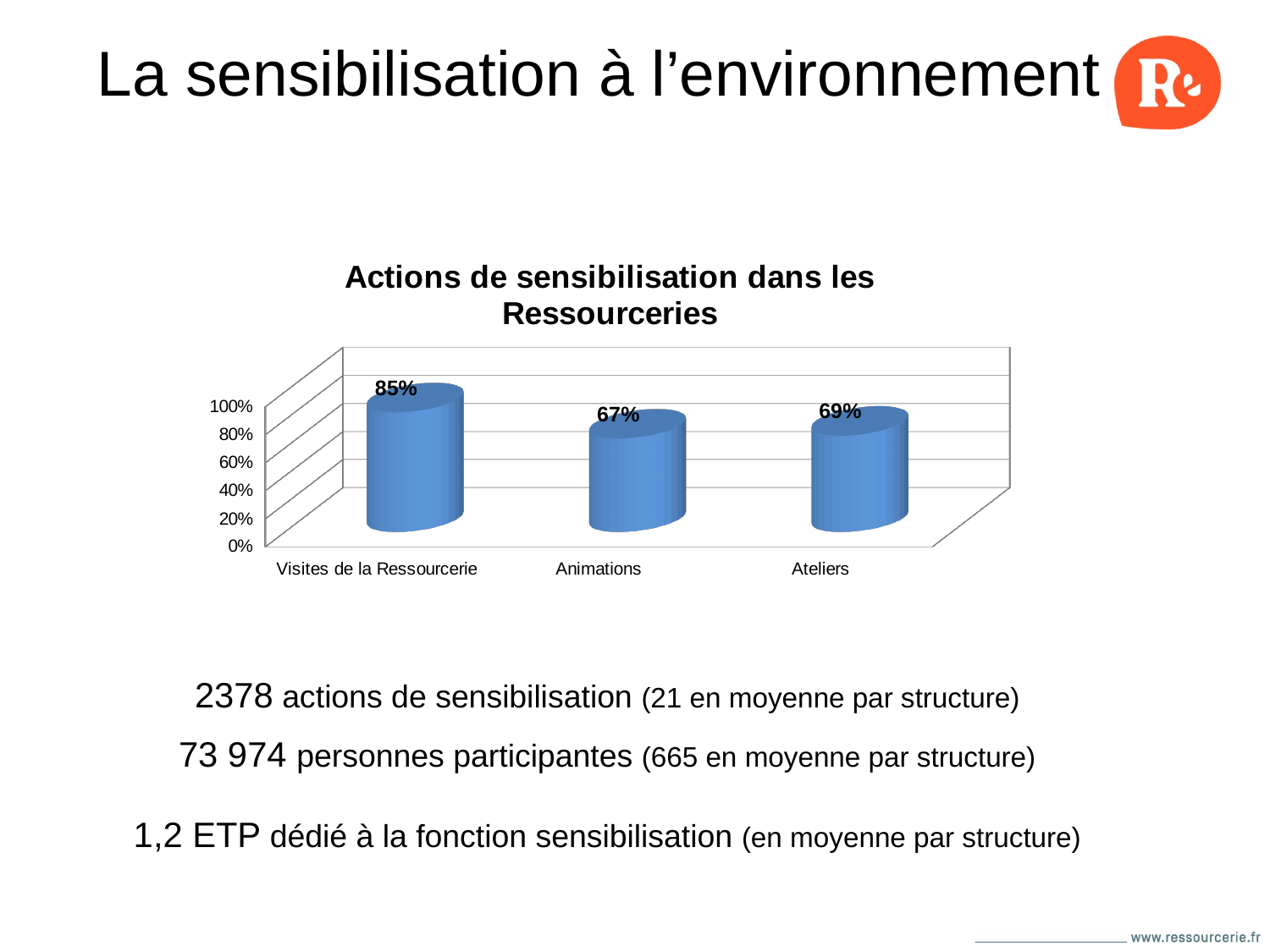
What is the title of the chart? Actions de sensibilisation dans les Ressourceries What is the value for Animations? 67% Which category has the lowest value? Animations Which category has the highest value? Visites de la Ressourcerie Which is larger, the value for Visites de la Ressourcerie or the value for Ateliers? Visites de la Ressourcerie What is the difference between the values for Visites de la Ressourcerie and Animations? 18% How many categories are shown in the chart? 3 What is the difference between the values for Ateliers and Animations? 2% What is the value for Visites de la Ressourcerie? 85% What is the value for Ateliers? 69% What kind of chart is shown on the slide? bar chart Is the value for Animations greater or less than 80%? less